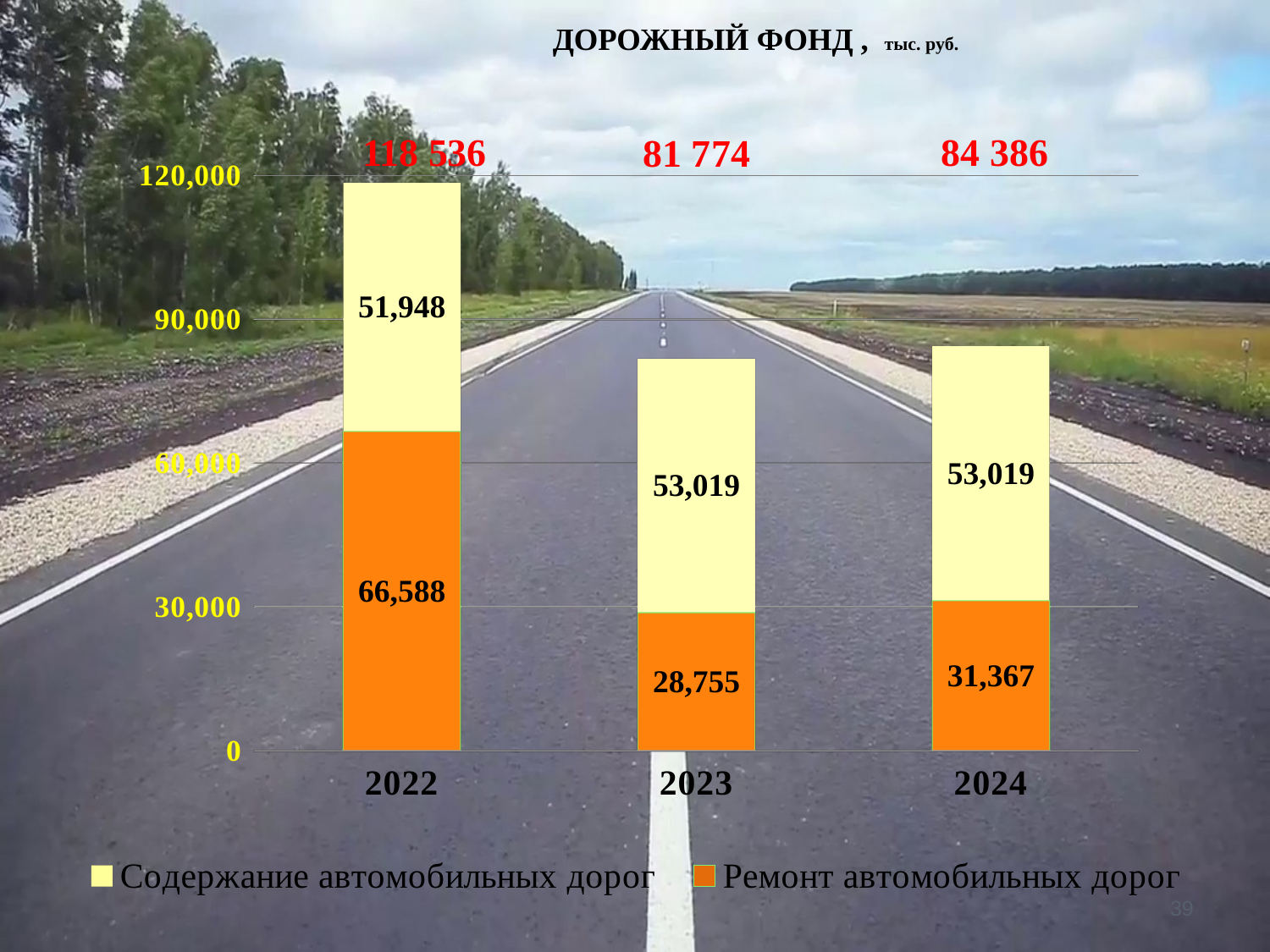
What is the value for Содержание автомобильных дорог in 2023? 53,019 Which is larger in 2022: Содержание автомобильных дорог or Ремонт автомобильных дорог? Ремонт автомобильных дорог How many series does the legend list? 2 What is the value for Ремонт автомобильных дорог in 2022? 66,588 Which year has the lowest value for Ремонт автомобильных дорог? 2023 What type of chart is shown on the slide? stacked bar chart How many years are shown on the x axis? 3 What is the total of the stacked bar for 2022? 118 536 What is the total of the stacked bar for 2023? 81 774 What is the difference between Ремонт автомобильных дорог in 2024 and in 2023? 2,612 What is the value for Ремонт автомобильных дорог in 2024? 31,367 Which year has the highest total road fund? 2022